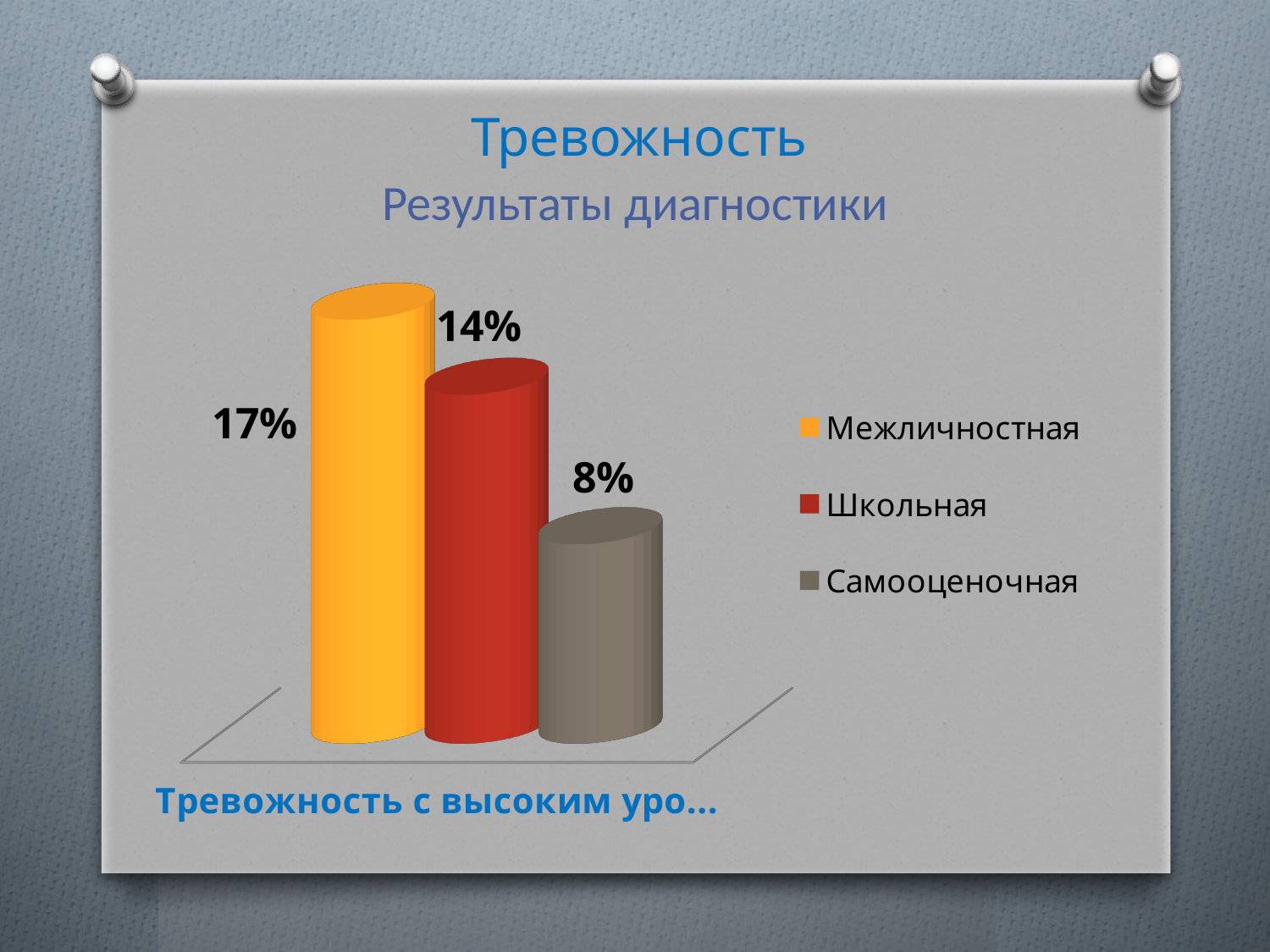
What colour is the bar for Школьная? Red Which series has the lowest value? Самооценочная What is the value for Межличностная? 17% What is the title of the slide? Тревожность Результаты диагностики Which is larger, the value for Школьная or the value for Самооценочная? Школьная What is the value for Школьная? 14% What is the difference between the values for Школьная and Самооценочная? 6% What is the value for Самооценочная? 8% How many series does the legend list? 3 Which series has the highest value? Межличностная What kind of chart is shown on the slide? Bar chart What is the difference between the values for Межличностная and Школьная? 3%